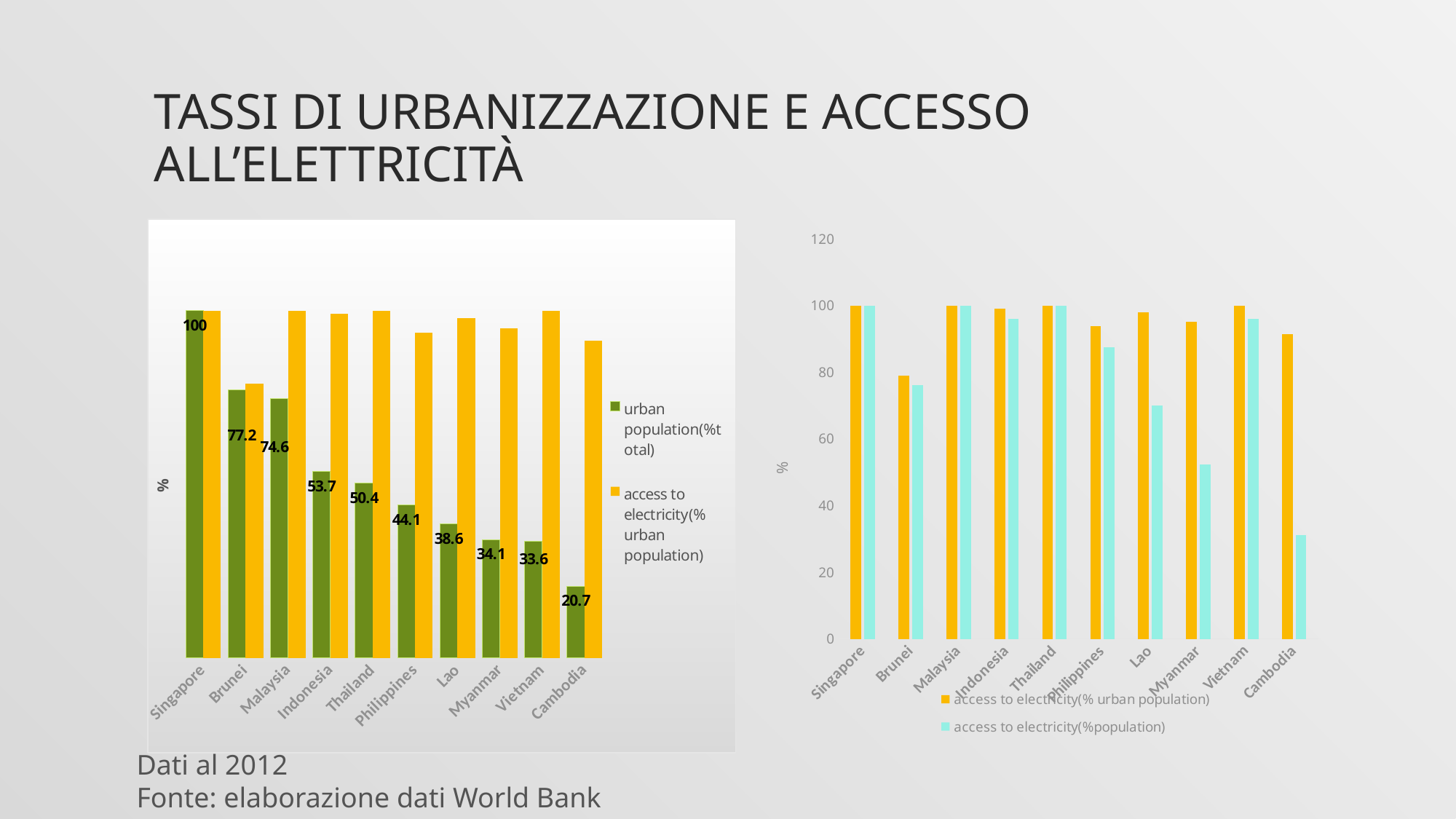
How many series does the legend of the right chart list? 2 What kind of chart is the right chart? bar chart On the left chart, what is the difference between the urban population (% total) values for Brunei and Malaysia? 2.6 On the right chart, is the access to electricity (% population) value for Cambodia greater or less than 40? less On the left chart, which country has the lowest urban population (% total)? Cambodia On the left chart, which country has the highest urban population (% total)? Singapore On the left chart, what is the urban population (% total) value for Indonesia? 53.7 On the left chart, what is the urban population (% total) value for Cambodia? 20.7 On the right chart, is the access to electricity (% population) value for Lao greater or less than 60? greater How many countries are shown on the left chart? 10 On the left chart, which is larger: the urban population (% total) for Thailand or for Philippines? Thailand On the left chart, what colour are the bars for urban population (% total)? green